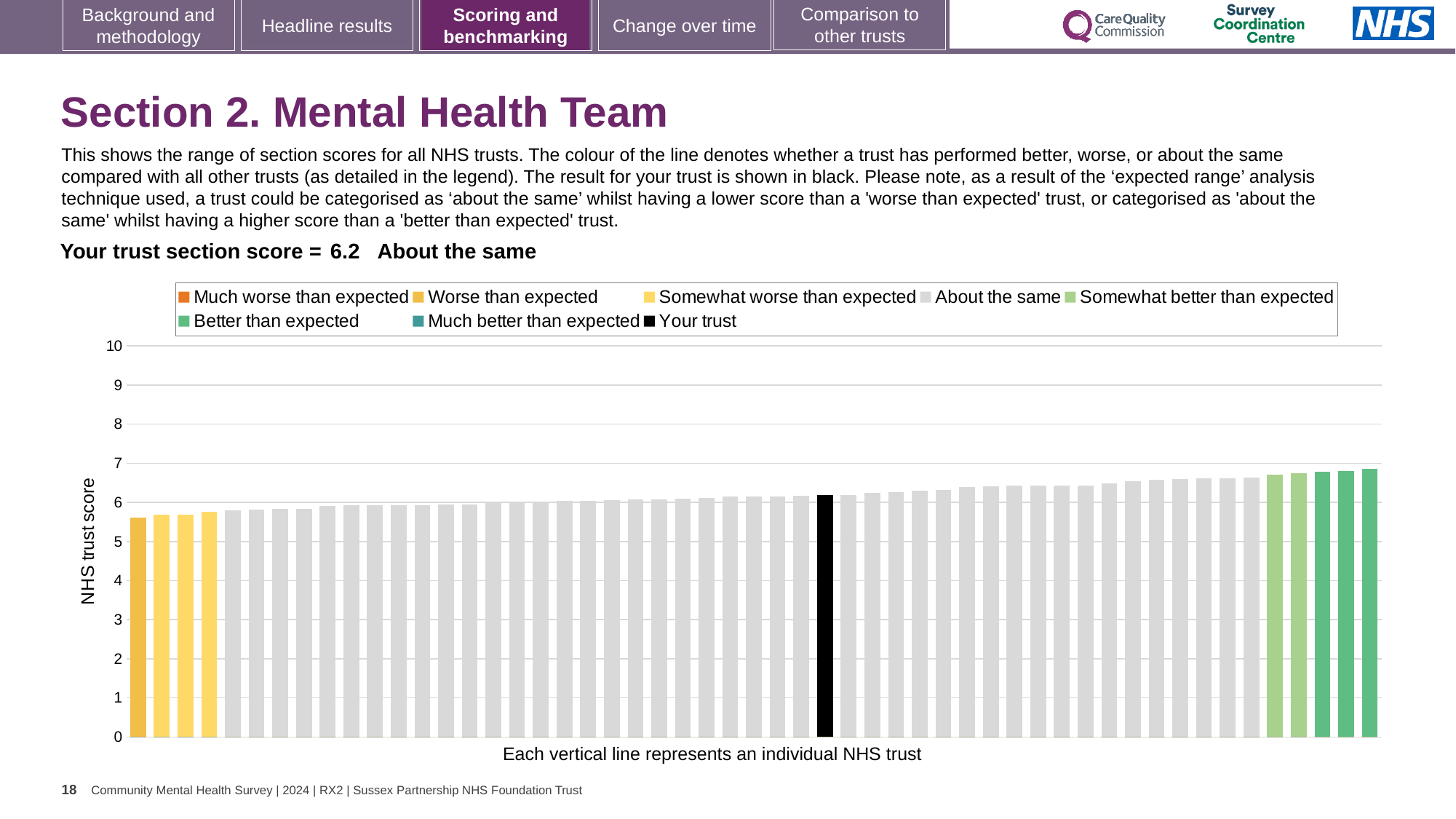
How many bars are coloured black? 1 Do the bar values rise or fall from left to right along the x axis? rise What kind of chart is shown on the slide? bar chart What does the caption below the x axis say each vertical line represents? an individual NHS trust What is the label on the vertical axis of the chart? NHS trust score How many bars are coloured yellow (worse or somewhat worse than expected) at the left of the chart? 4 Which category is your trust placed in for this section? About the same What is the section score for your trust shown on the slide? 6.2 Is the value of the tallest bar greater or less than 7? less How many entries does the chart legend list? 8 Is the value of the black bar (your trust) greater or less than 5? greater Is the value of the shortest bar greater or less than 5? greater